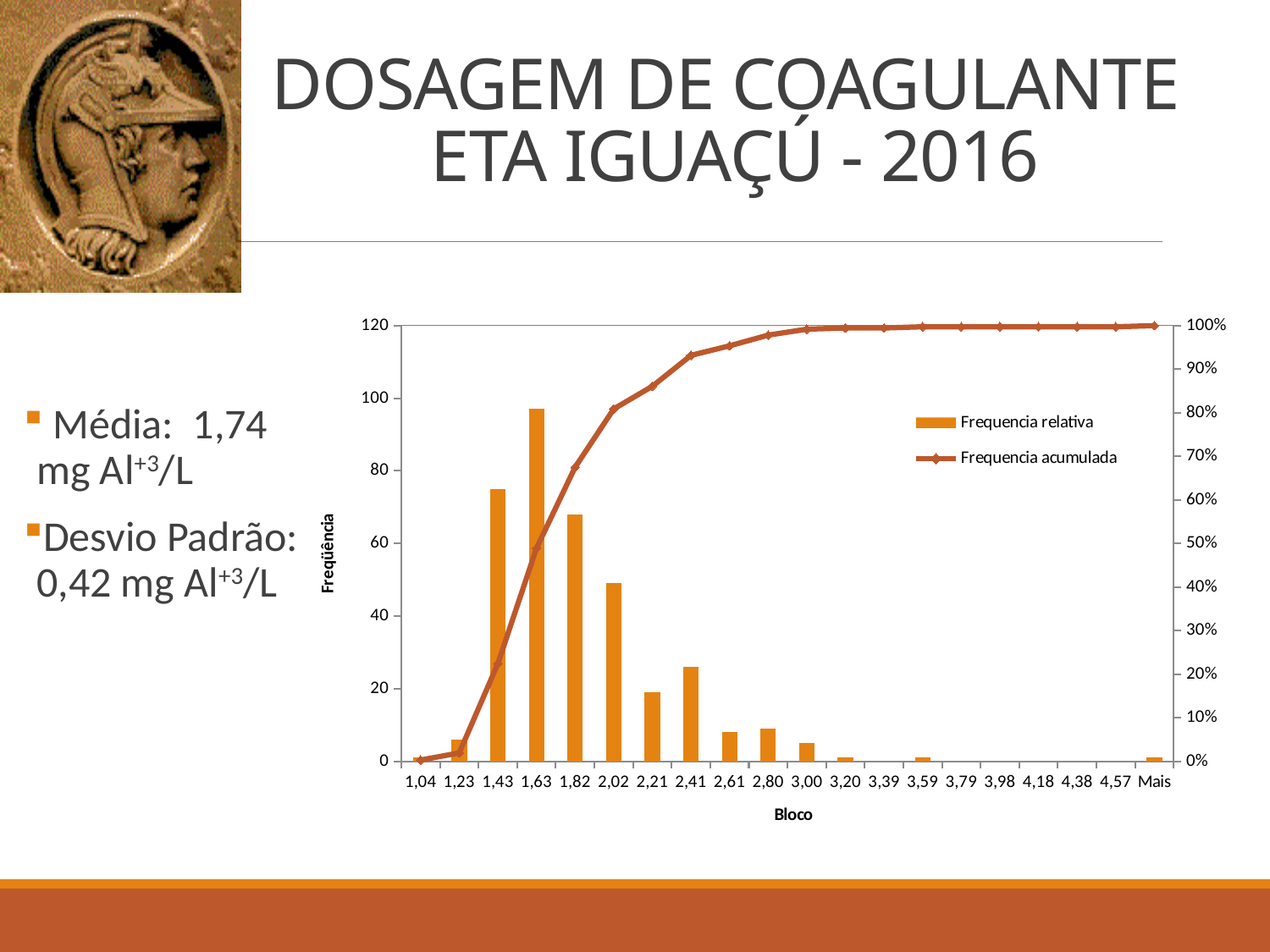
How many series does the chart legend list? 2 Does the Frequencia acumulada line rise or fall along the x axis? rise Which has the larger Frequencia relativa bar, Bloco 2,02 or Bloco 2,41? 2,02 How many categories are shown on the x axis (Bloco) of the chart? 20 Is the Frequencia relativa value for Bloco 2,61 greater or less than 20? less What kind of chart is shown on the slide? A combined bar and line chart Is the Frequencia acumulada value at Bloco 1,43 greater or less than 30%? less Is the Frequencia acumulada value at Bloco 2,41 greater or less than 90%? greater What is the title of the x axis of the chart? Bloco Which Bloco category has the highest Frequencia relativa bar? 1,63